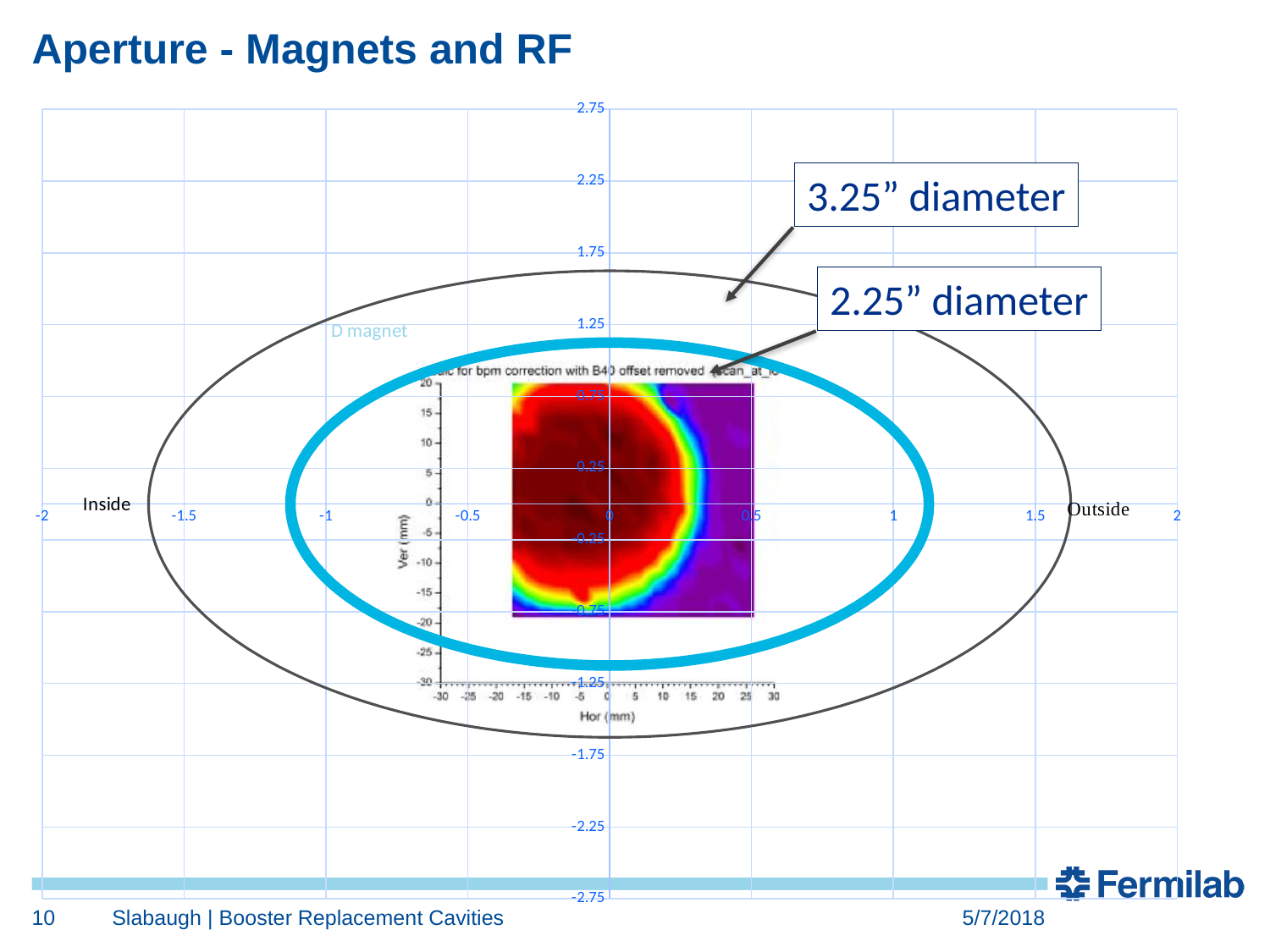
What is the difference between the two labelled diameters? 1" What colour is the 2.25" diameter ellipse? blue What kind of chart is shown on the slide? scatter chart What is the lowest value shown on the horizontal axis of the chart? -2 Which ellipse is larger, the 3.25" diameter one or the 2.25" diameter one? 3.25" diameter What diameter is labelled for the outer (black) ellipse? 3.25" diameter What diameter is labelled for the inner (blue) ellipse? 2.25" diameter How many ellipses (apertures) are drawn on the chart? 2 What is the highest value shown on the vertical axis of the chart? 2.75 What label appears at the left end of the horizontal axis? Inside